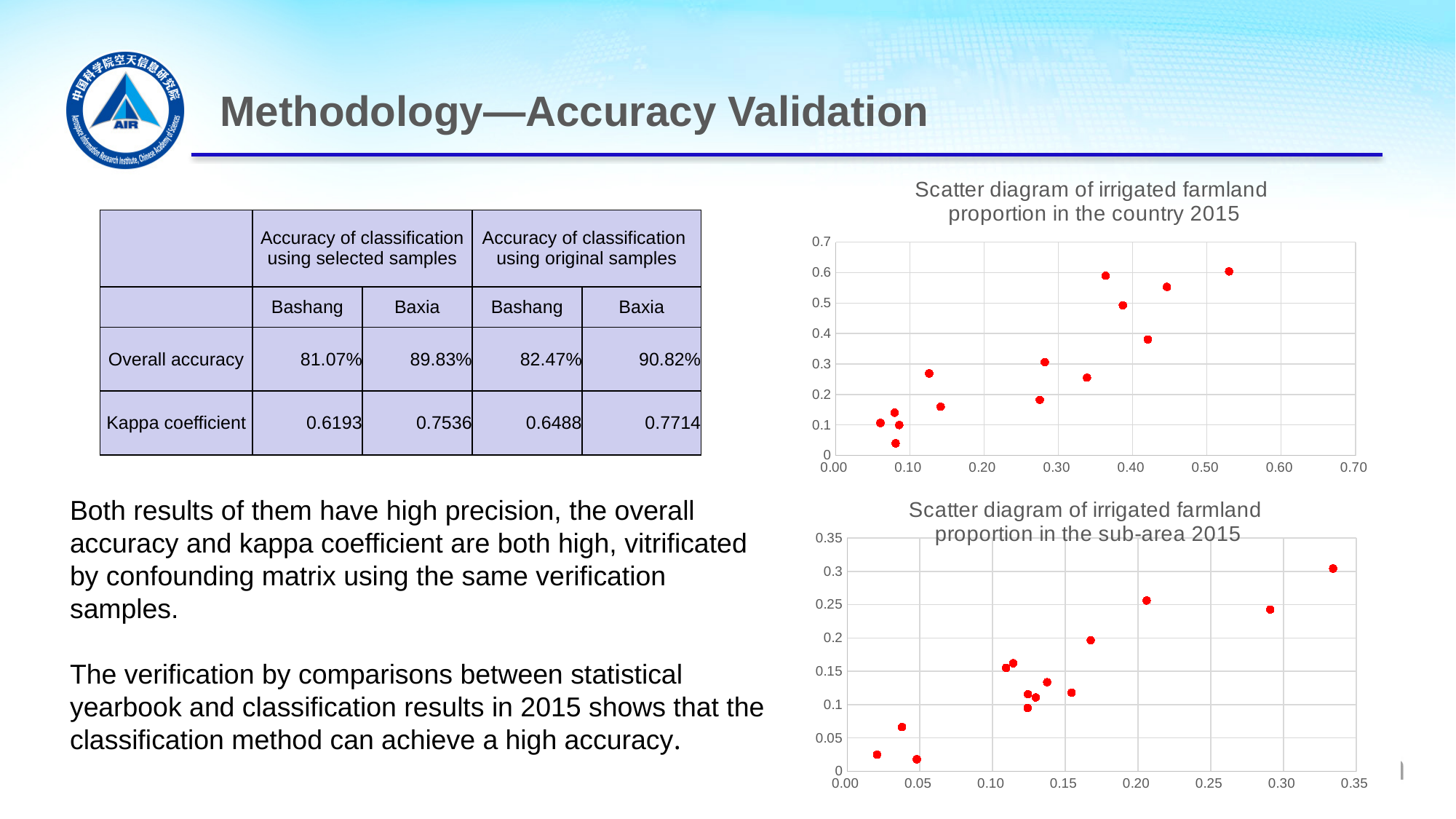
How many points are plotted in the 'Scatter diagram of irrigated farmland proportion in the sub-area 2015'? 14 What kind of chart is the 'Scatter diagram of irrigated farmland proportion in the sub-area 2015'? scatter chart In the 'Scatter diagram of irrigated farmland proportion in the sub-area 2015', is the y value of the rightmost point greater or less than 0.25? greater What is the maximum value shown on the y axis of the 'Scatter diagram of irrigated farmland proportion in the country 2015'? 0.7 How many points are plotted in the 'Scatter diagram of irrigated farmland proportion in the country 2015'? 14 In the 'Scatter diagram of irrigated farmland proportion in the country 2015', is the y value of the highest point greater or less than 0.5? greater In the 'Scatter diagram of irrigated farmland proportion in the sub-area 2015', is the y value of the highest point greater or less than 0.35? less In the 'Scatter diagram of irrigated farmland proportion in the sub-area 2015', do the y values generally rise or fall as the x values increase? rise What is the maximum value shown on the x axis of the 'Scatter diagram of irrigated farmland proportion in the sub-area 2015'? 0.35 In the 'Scatter diagram of irrigated farmland proportion in the country 2015', do the y values generally rise or fall as the x values increase? rise What kind of chart is the 'Scatter diagram of irrigated farmland proportion in the country 2015'? scatter chart